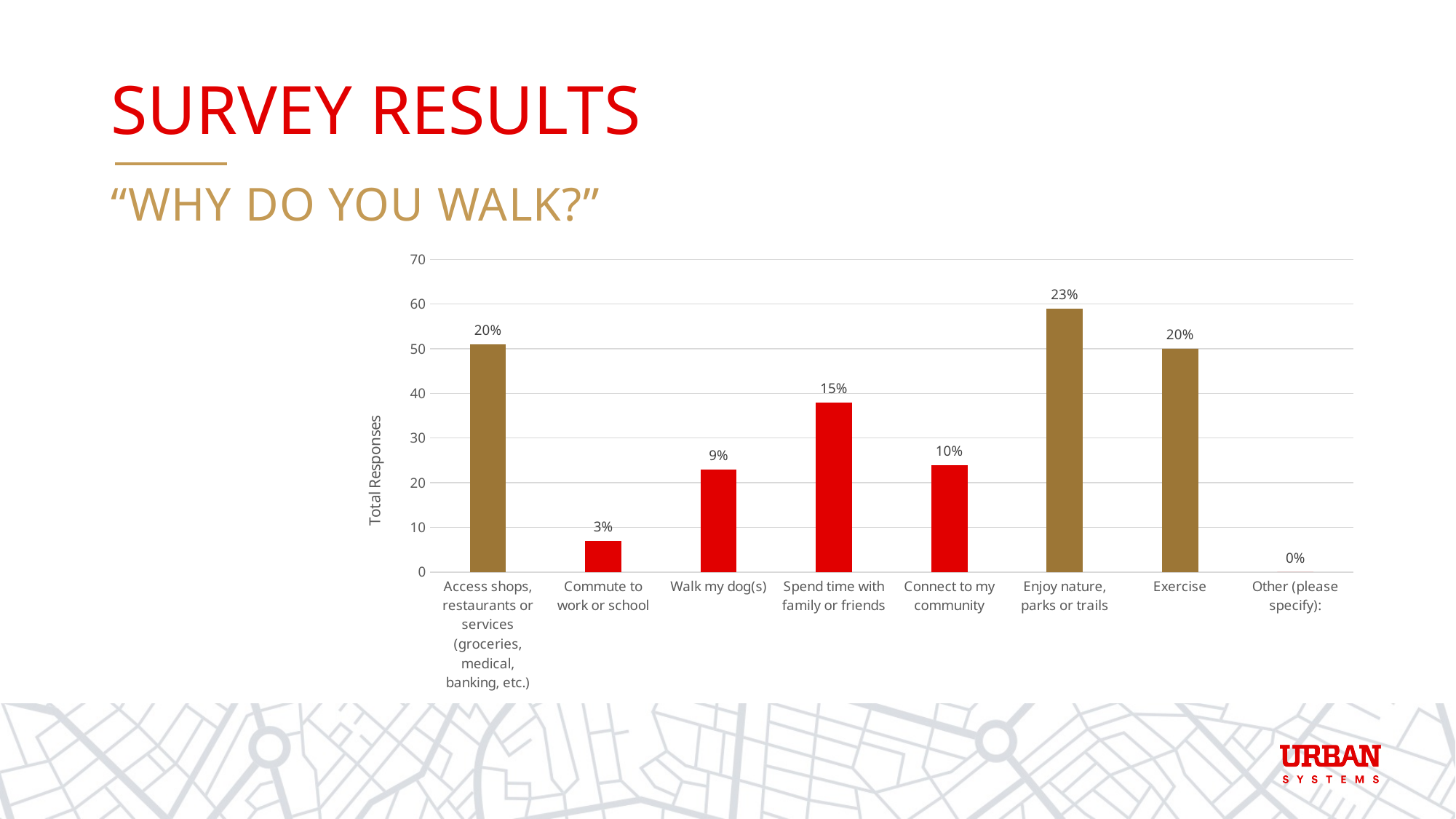
What kind of chart is shown on the slide? Bar chart Which reason for walking has the highest value? Enjoy nature, parks or trails Which is larger: "Spend time with family or friends" or "Connect to my community"? Spend time with family or friends What percentage label is shown for "Walk my dog(s)"? 9% What percentage label is shown for "Enjoy nature, parks or trails"? 23% How many categories are shown on the x axis? 8 Is the total responses value for "Connect to my community" greater or less than 20? greater What percentage label is shown for "Commute to work or school"? 3% Is the total responses value for "Spend time with family or friends" greater or less than 40? less Which category has the lowest value? Other (please specify): By how many percentage points does "Spend time with family or friends" exceed "Walk my dog(s)"? 6 What percentage label is shown for "Spend time with family or friends"? 15%